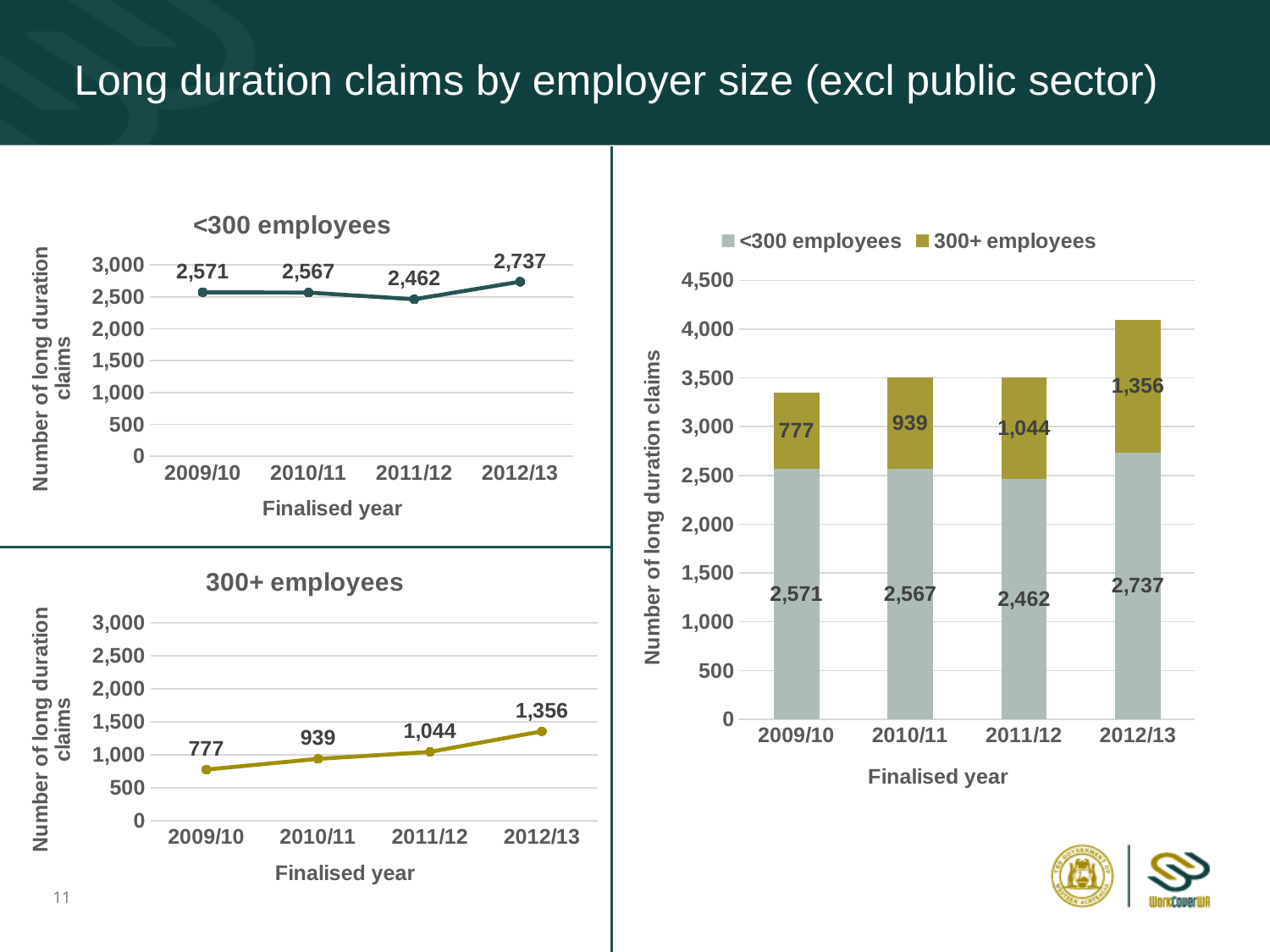
How many finalised years are shown on the x axis of the stacked bar chart on the right? 4 What kind of chart is the '<300 employees' chart on the top left? line chart In the '<300 employees' chart, what is the number of long duration claims for 2011/12? 2,462 In the '300+ employees' chart, do the values rise or fall from 2009/10 to 2012/13? rise How many series does the legend of the stacked bar chart on the right list? 2 In the '300+ employees' chart, what is the number of long duration claims for 2010/11? 939 In the stacked bar chart on the right, what is the total number of long duration claims for 2009/10? 3,348 In the '300+ employees' chart, which finalised year has the lowest number of long duration claims? 2009/10 In the '300+ employees' chart, what is the difference between the 2012/13 and 2009/10 values? 579 In the '<300 employees' chart, which is larger: the value for 2009/10 or the value for 2011/12? 2009/10 In the '<300 employees' chart, which finalised year has the highest number of long duration claims? 2012/13 In the stacked bar chart on the right, what is the total number of long duration claims for 2012/13? 4,093